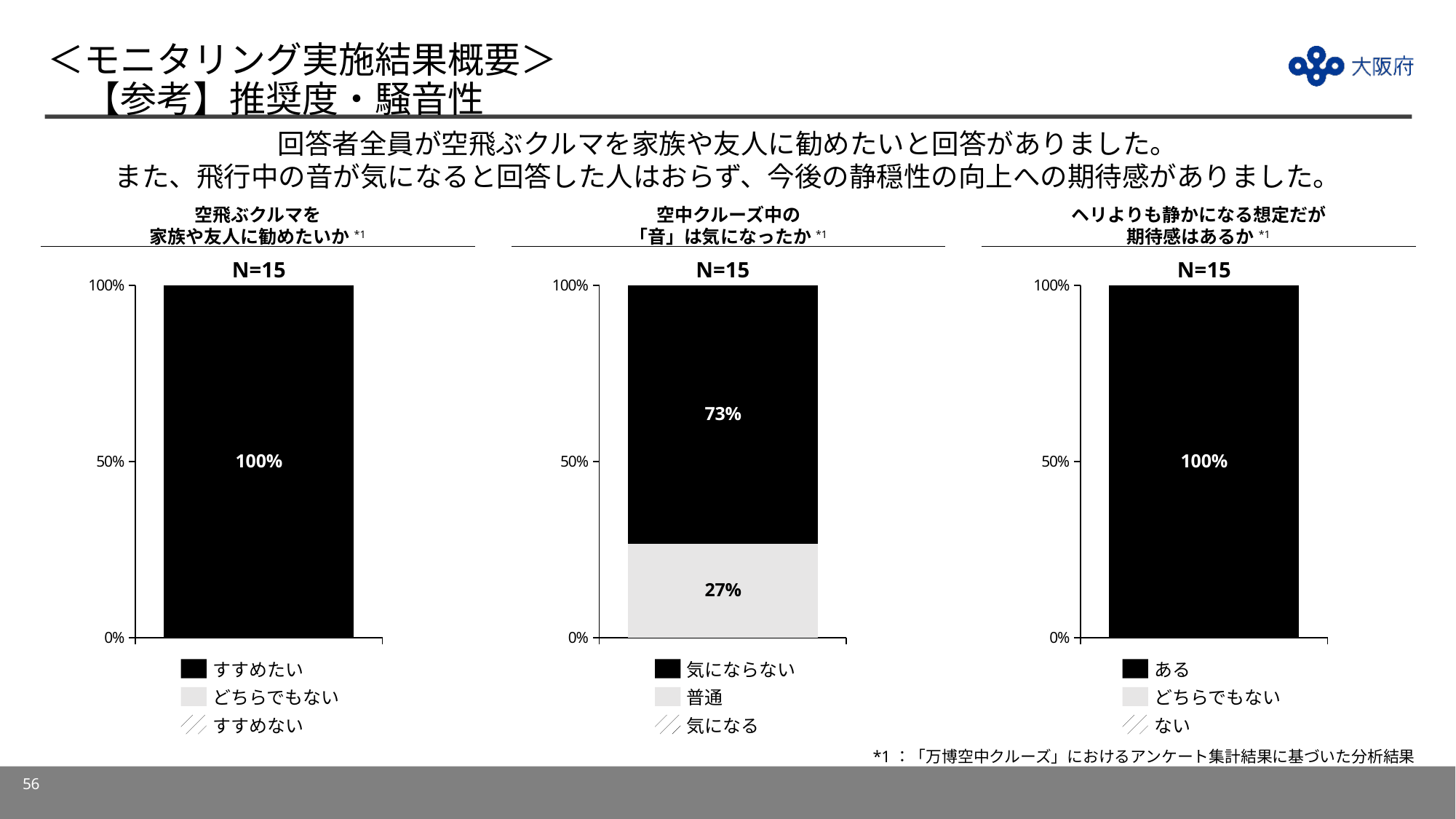
How many charts are shown on the slide? 3 In the middle chart (空中クルーズ中の「音」は気になったか), what is the total of the stacked bar? 100% In the middle chart (空中クルーズ中の「音」は気になったか), what is the difference in percentage points between the 気にならない and 普通 segments? 46 In the middle chart (空中クルーズ中の「音」は気になったか), which response has the larger share: 気にならない or 普通? 気にならない What type of chart is the middle chart (空中クルーズ中の「音」は気になったか)? Stacked bar chart How many entries does the legend of the right chart (ヘリよりも静かになる想定だが期待感はあるか) list? 3 What is the sample size (N) shown for the left chart (空飛ぶクルマを家族や友人に勧めたいか)? N=15 In the middle chart (空中クルーズ中の「音」は気になったか), what percentage of respondents answered 気にならない? 73% In the right chart (ヘリよりも静かになる想定だが期待感はあるか), what percentage of respondents answered ある? 100% In the left chart (空飛ぶクルマを家族や友人に勧めたいか), what percentage of respondents answered すすめたい? 100% In the middle chart (空中クルーズ中の「音」は気になったか), what percentage of respondents answered 普通? 27% In the middle chart (空中クルーズ中の「音」は気になったか), is the value for 気にならない greater or less than 50%? greater